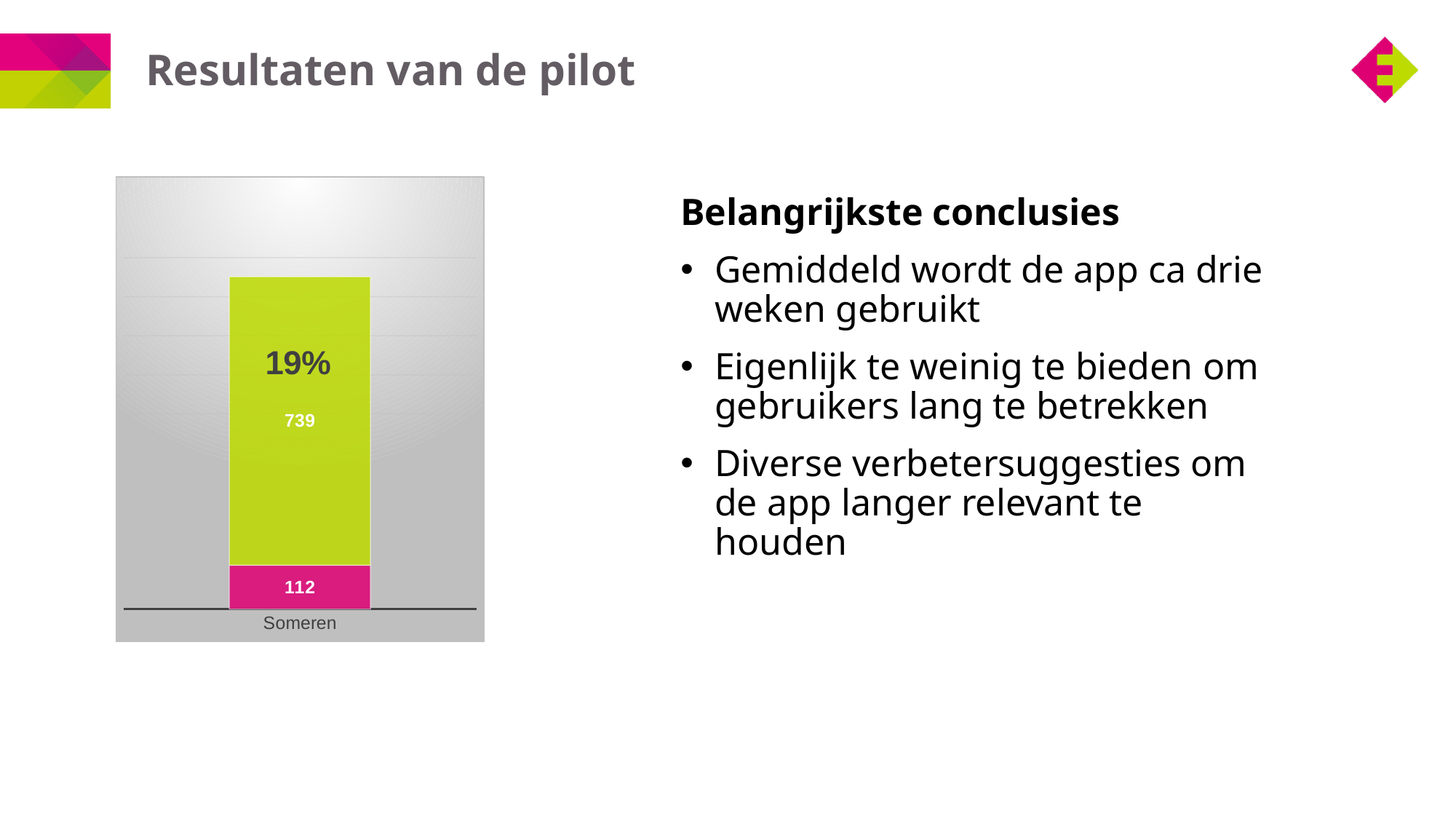
What percentage is printed on the bar for Someren? 19% What kind of chart is shown on the slide? stacked bar chart What is the difference between the green segment (739) and the magenta segment (112) of the Someren bar? 627 What is the total of the stacked bar for Someren? 851 How many categories are shown on the x axis of the chart? 1 What value is printed on the magenta segment of the bar for Someren? 112 Which segment of the Someren bar is larger, the green one or the magenta one? the green one What is the category label shown under the bar? Someren What value is printed on the green segment of the bar for Someren? 739 Which segment of the bar is at the bottom, the green one or the magenta one? the magenta one